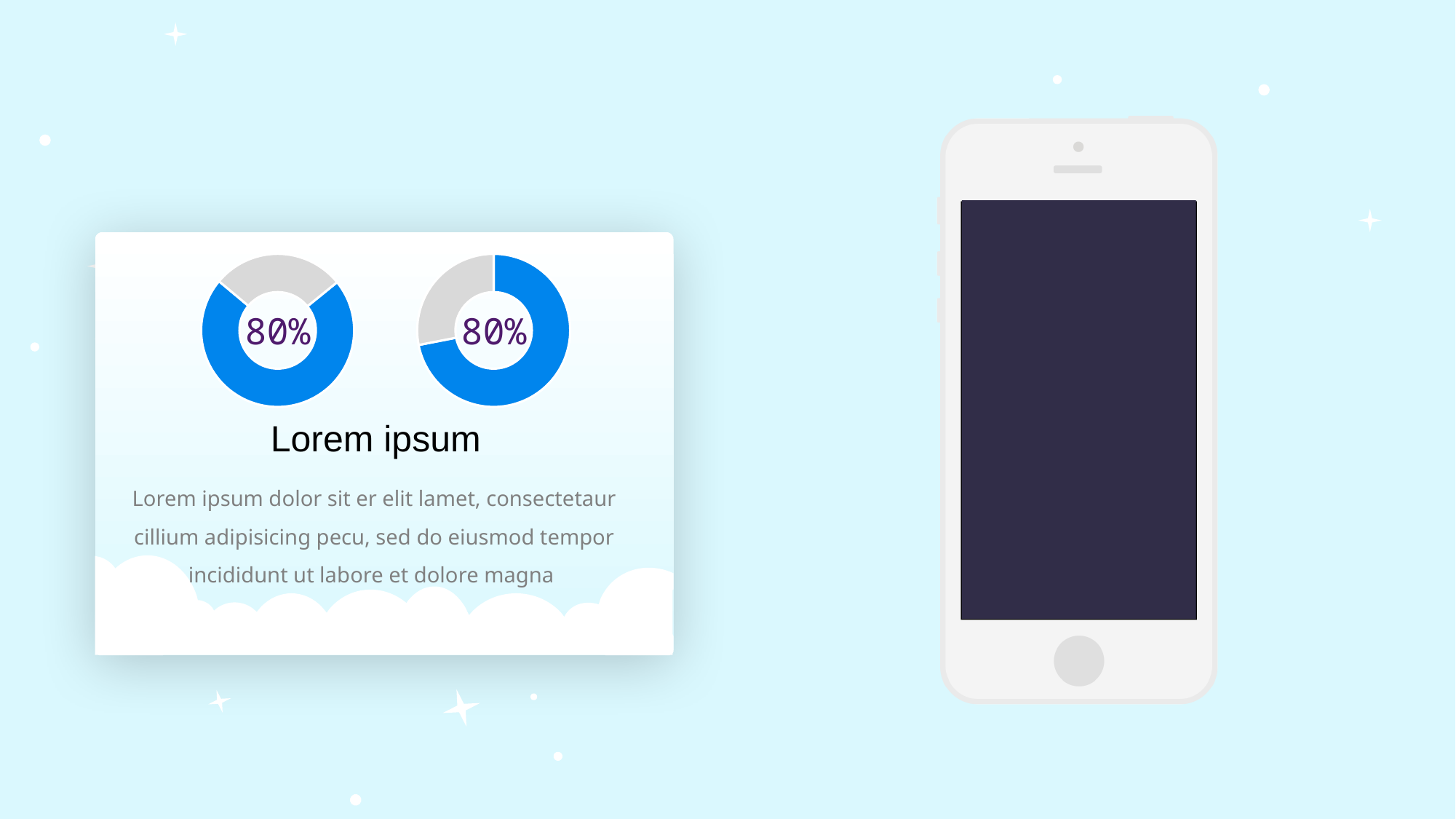
What percentage is printed in the centre of the right donut chart? 80% What colour is the unfilled (smaller) portion of the donut charts? Grey What kind of chart is shown on the left of the white card? Donut chart What percentage is printed in the centre of the left donut chart? 80% How many donut charts are on the slide? 2 Is the percentage shown in the left donut chart greater or less than 50%? greater How many segments does each donut chart have? 2 Is the percentage shown in the right donut chart greater or less than 50%? greater What colour is the filled (larger) portion of the donut charts? Blue What kind of chart is shown on the right of the white card? Donut chart